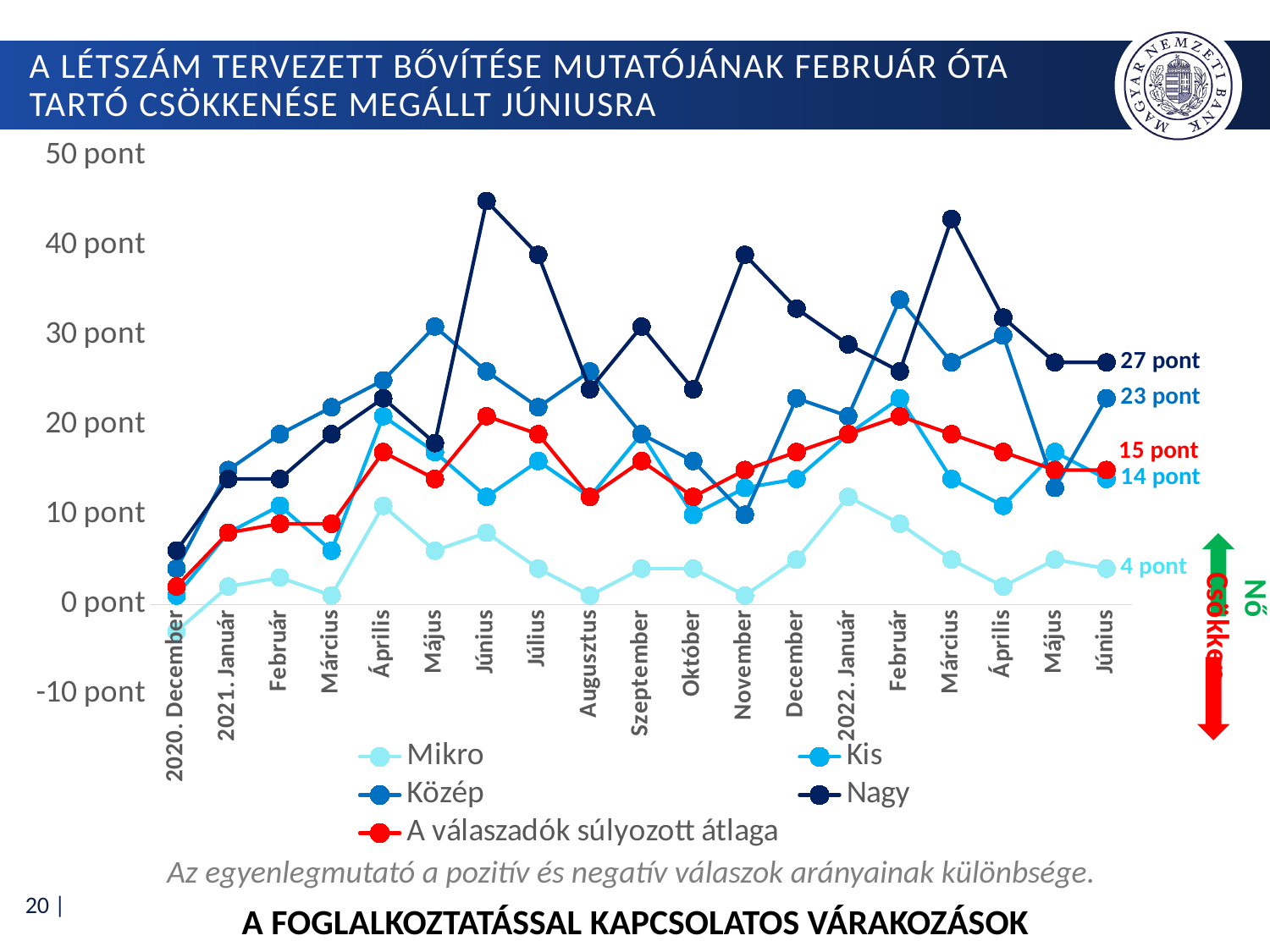
Which series has the highest value in 2022 Június? Nagy What is the difference between the Nagy and Mikro values in 2022 Június? 23 pont How many months are plotted along the x axis? 19 What colour is the line for 'A válaszadók súlyozott átlaga'? red Is the value for Nagy in 2021 Június greater or less than 40 pont? greater What is the value of the Nagy series in 2022 Június? 27 pont What is the value of 'A válaszadók súlyozott átlaga' in 2022 Június? 15 pont What is the value of the Mikro series in 2022 Június? 4 pont How many series does the legend list? 5 What is the value of the Közép series in 2022 Június? 23 pont In 2022 Június, which is larger: the Közép value or the Kis value? Közép What kind of chart is shown on the slide? line chart